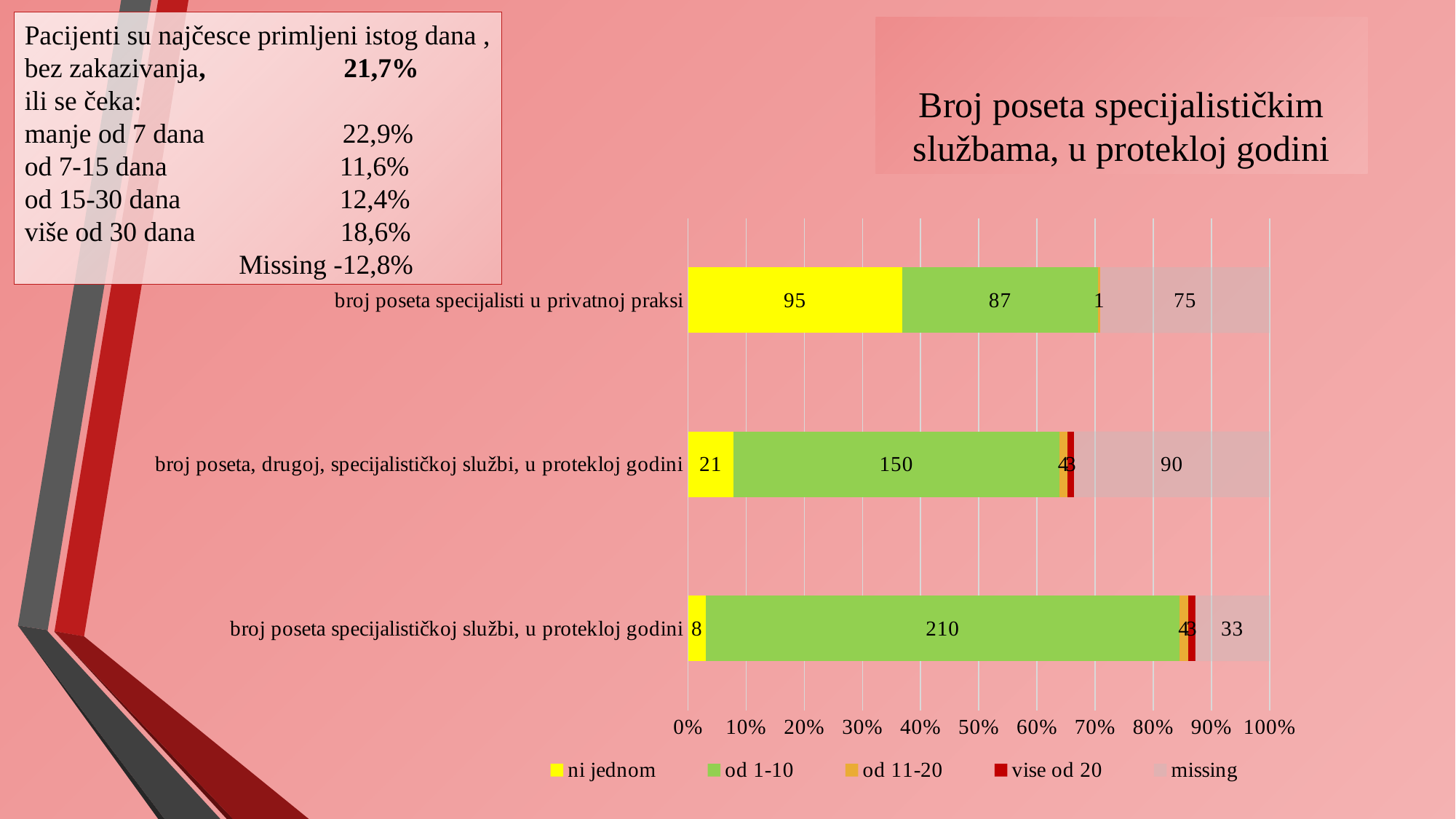
What is the difference between the 'od 1-10' values for 'broj poseta specijalističkoj službi, u protekloj godini' and 'broj poseta, drugoj, specijalističkoj službi, u protekloj godini'? 60 How many categories (bars) does the chart show? 3 What is the value of 'ni jednom' for 'broj poseta specijalisti u privatnoj praksi'? 95 What is the title of the chart? Broj poseta specijalističkim službama, u protekloj godini What is the 'missing' value for 'broj poseta, drugoj, specijalističkoj službi, u protekloj godini'? 90 Which is larger: the 'missing' value for 'broj poseta specijalisti u privatnoj praksi' or for 'broj poseta specijalističkoj službi, u protekloj godini'? broj poseta specijalisti u privatnoj praksi How many series does the legend list? 5 What is the value of 'od 1-10' for 'broj poseta specijalističkoj službi, u protekloj godini'? 210 What is the value of 'od 1-10' for 'broj poseta specijalisti u privatnoj praksi'? 87 Which category has the highest 'od 1-10' value? broj poseta specijalističkoj službi, u protekloj godini Which category has the lowest 'ni jednom' value? broj poseta specijalističkoj službi, u protekloj godini What type of chart is shown on the slide? Stacked bar chart